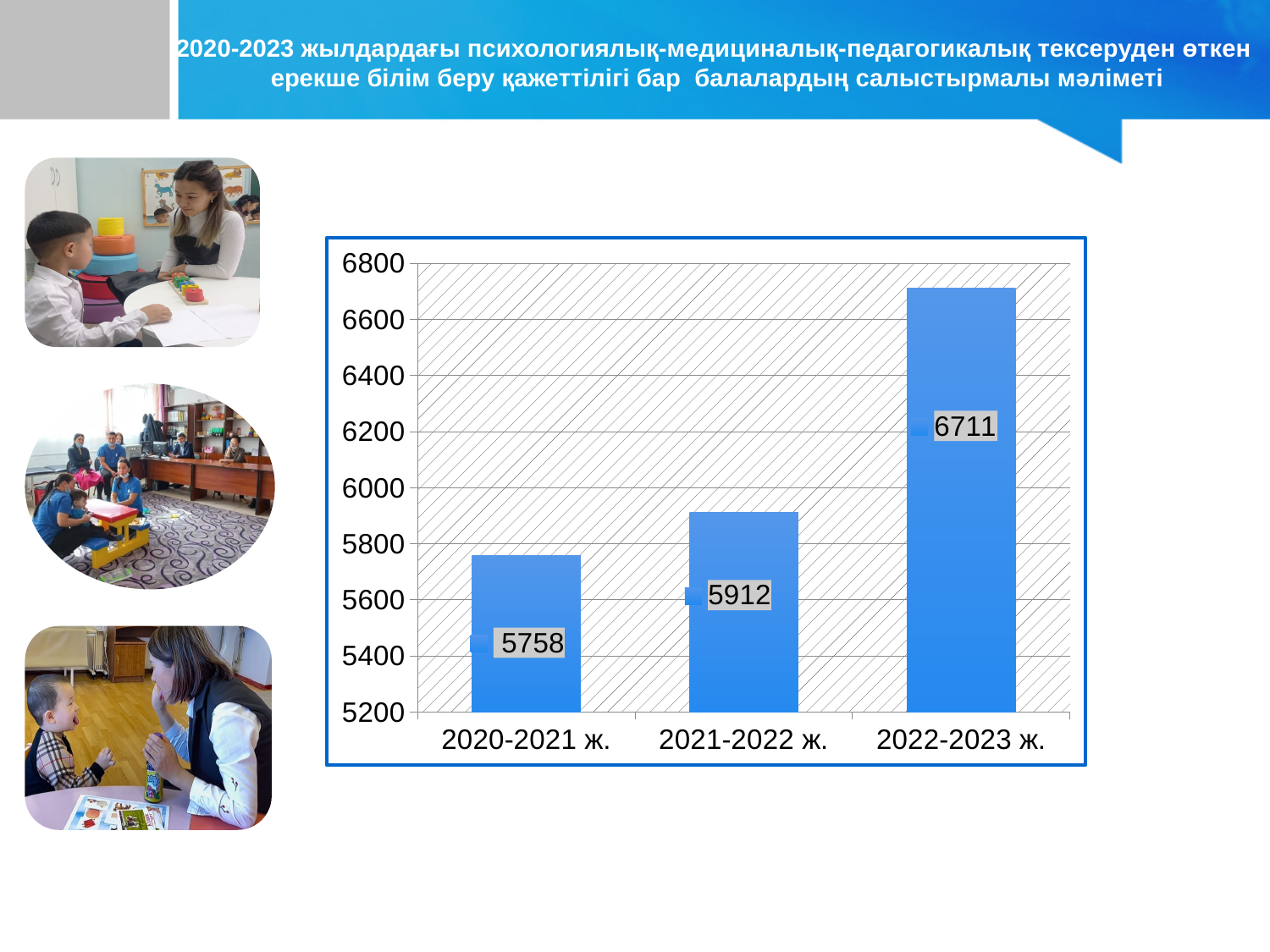
Which category has the lowest value? 2020-2021 ж. What is the difference between the values for 2022-2023 ж. and 2020-2021 ж.? 953 What is the value for 2021-2022 ж.? 5912 Which is larger, the value for 2021-2022 ж. or the value for 2022-2023 ж.? 2022-2023 ж. Which category has the highest value? 2022-2023 ж. What kind of chart is shown on the slide? bar chart What is the value for 2020-2021 ж.? 5758 What is the value for 2022-2023 ж.? 6711 How many categories are shown on the x axis? 3 Do the values rise or fall from 2020-2021 ж. to 2022-2023 ж.? rise What is the difference between the values for 2021-2022 ж. and 2020-2021 ж.? 154 Is the value for 2021-2022 ж. greater or less than 6000? less